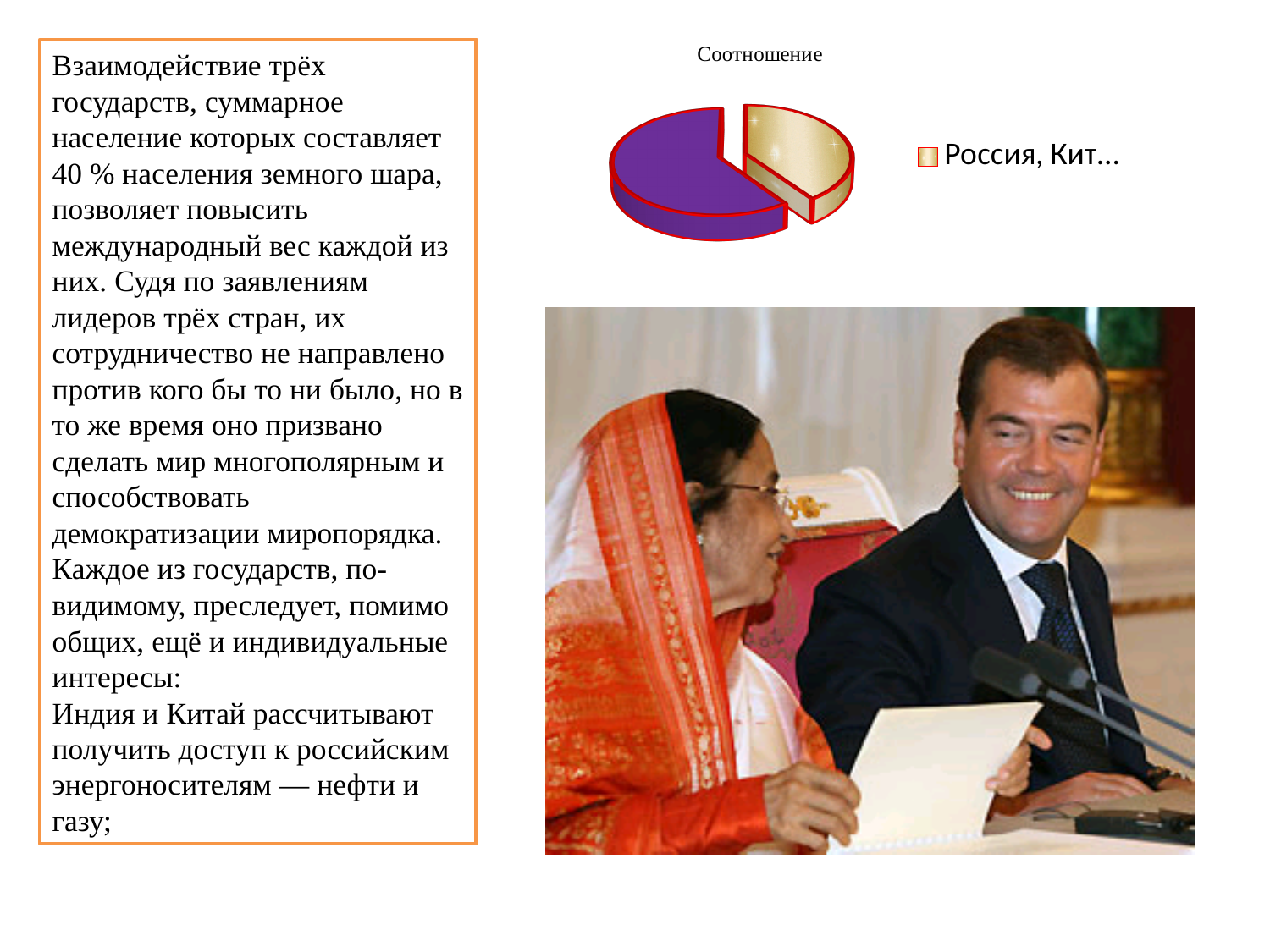
Is the slice labelled "Россия, Кит..." the larger or the smaller slice of the pie? the smaller What is the legend entry shown next to the pie chart? Россия, Кит... What is the title of the pie chart? Соотношение How many entries does the legend of the pie chart list? 1 What kind of chart is shown on the slide? pie chart How many slices does the pie chart have? 2 Which slice of the pie chart is pulled out (exploded) from the rest? the beige slice (Россия, Кит...) Which slice of the pie chart is larger, the purple one or the beige one? the purple one